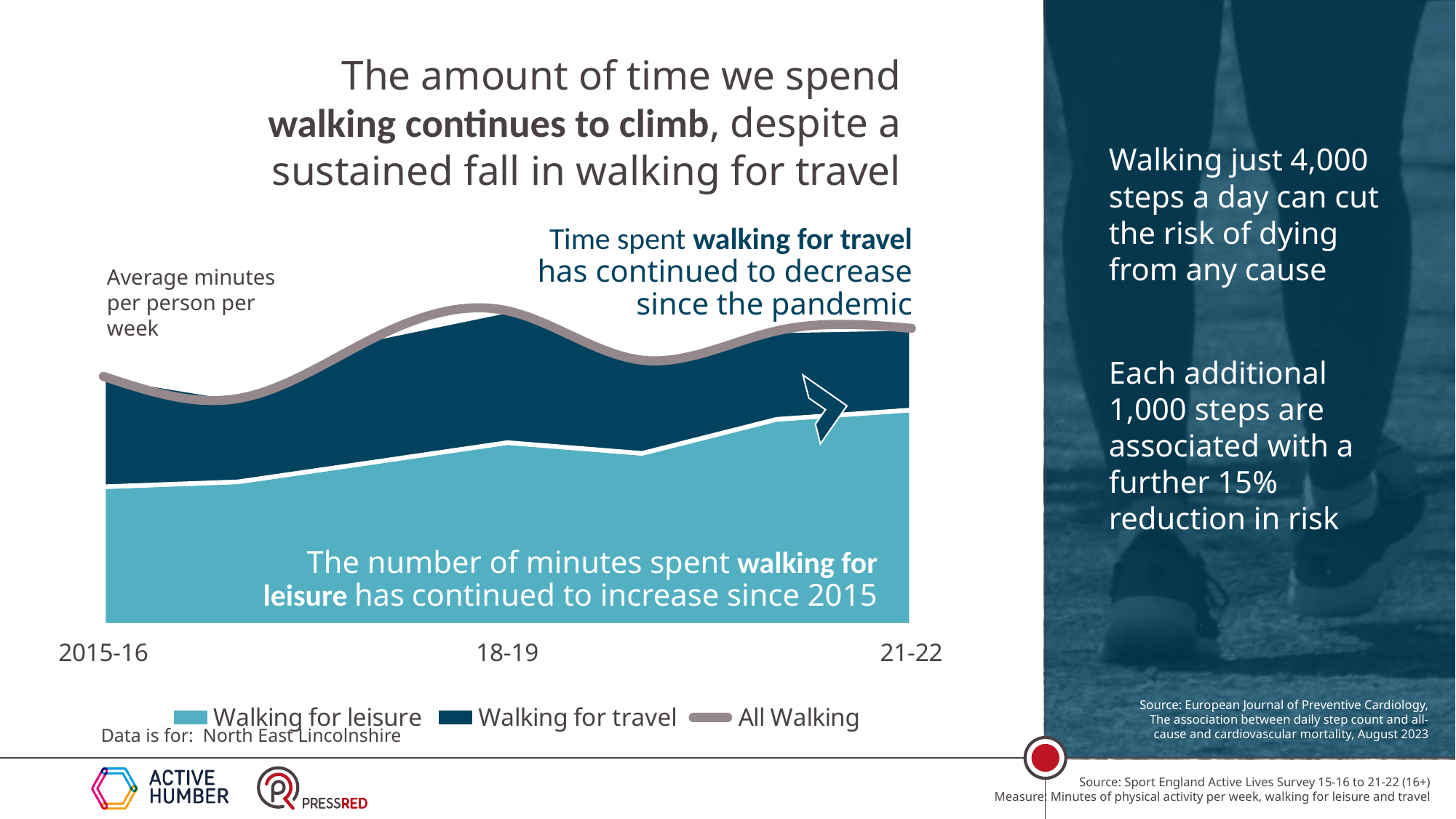
How many year labels are printed on the x axis of the chart? 3 In 21-22, which is larger: the minutes spent walking for leisure or walking for travel? Walking for leisure What kind of chart is shown on the slide? Stacked area chart Which area does the chart's data cover? North East Lincolnshire How many series does the chart legend list? 3 What is the first year label on the x axis of the chart? 2015-16 What is the last year label on the x axis of the chart? 21-22 Which series are listed in the chart legend? Walking for leisure, Walking for travel, All Walking Which series is drawn as the grey line along the top of the chart? All Walking According to the chart, does time spent walking for leisure rise or fall from 2015-16 to 21-22? Rise What measure does the chart's y axis represent? Average minutes per person per week According to the chart, has time spent walking for travel increased or decreased since the pandemic? Decreased